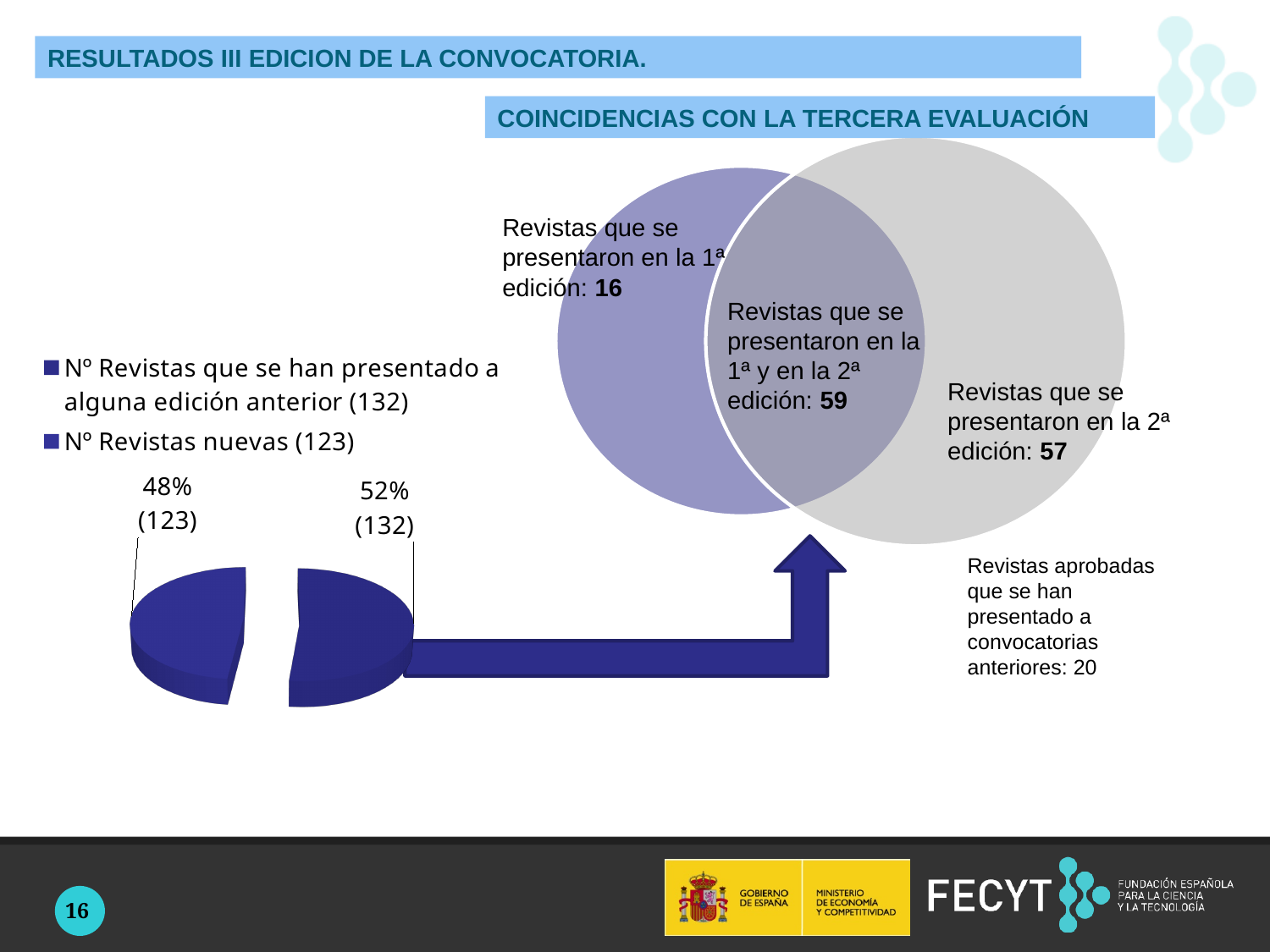
What kind of chart is shown on the left of the slide? pie chart In the pie chart, how many journals are counted as "Nº Revistas que se han presentado a alguna edición anterior"? 132 In the pie chart, what percentage share corresponds to "Nº Revistas nuevas"? 48% In the pie chart, what percentage share corresponds to "Nº Revistas que se han presentado a alguna edición anterior"? 52% Is the share for "Nº Revistas nuevas" in the pie chart greater or less than 50%? less What is the difference in number of journals between the two slices of the pie chart? 9 What is the total number of journals represented by the two slices of the pie chart? 255 How many entries does the legend of the pie chart list? 2 In the pie chart, how many journals are counted as "Nº Revistas nuevas"? 123 How many slices does the pie chart have? 2 Which slice of the pie chart is larger: "Nº Revistas nuevas" or "Nº Revistas que se han presentado a alguna edición anterior"? Nº Revistas que se han presentado a alguna edición anterior Which category has the smallest slice in the pie chart? Nº Revistas nuevas